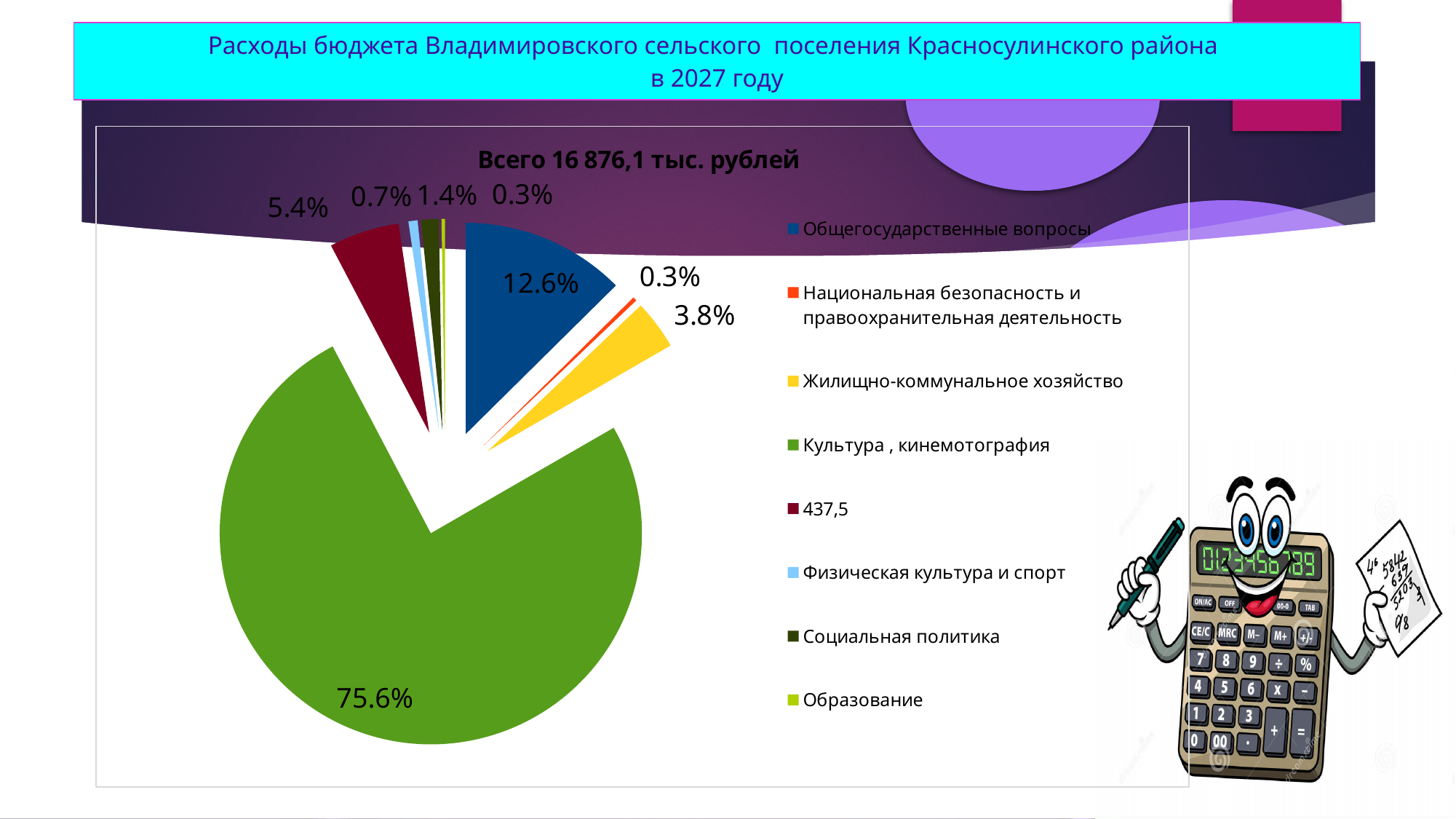
What colour is the slice for Общегосударственные вопросы? Blue Which is larger: Жилищно-коммунальное хозяйство or Социальная политика? Жилищно-коммунальное хозяйство What is the difference between the shares of Культура , кинемотография and Общегосударственные вопросы? 63.0% What is the title printed above the pie chart? Всего 16 876,1 тыс. рублей What is the value for Физическая культура и спорт? 0.7% Which category has the largest slice of the pie? Культура , кинемотография What is the value shown for Общегосударственные вопросы? 12.6% What kind of chart is shown on the slide? Pie chart What share of the pie does Культура , кинемотография account for? 75.6% How many categories does the legend list? 8 What percentage is labelled for Жилищно-коммунальное хозяйство? 3.8% What is the value for Социальная политика? 1.4%